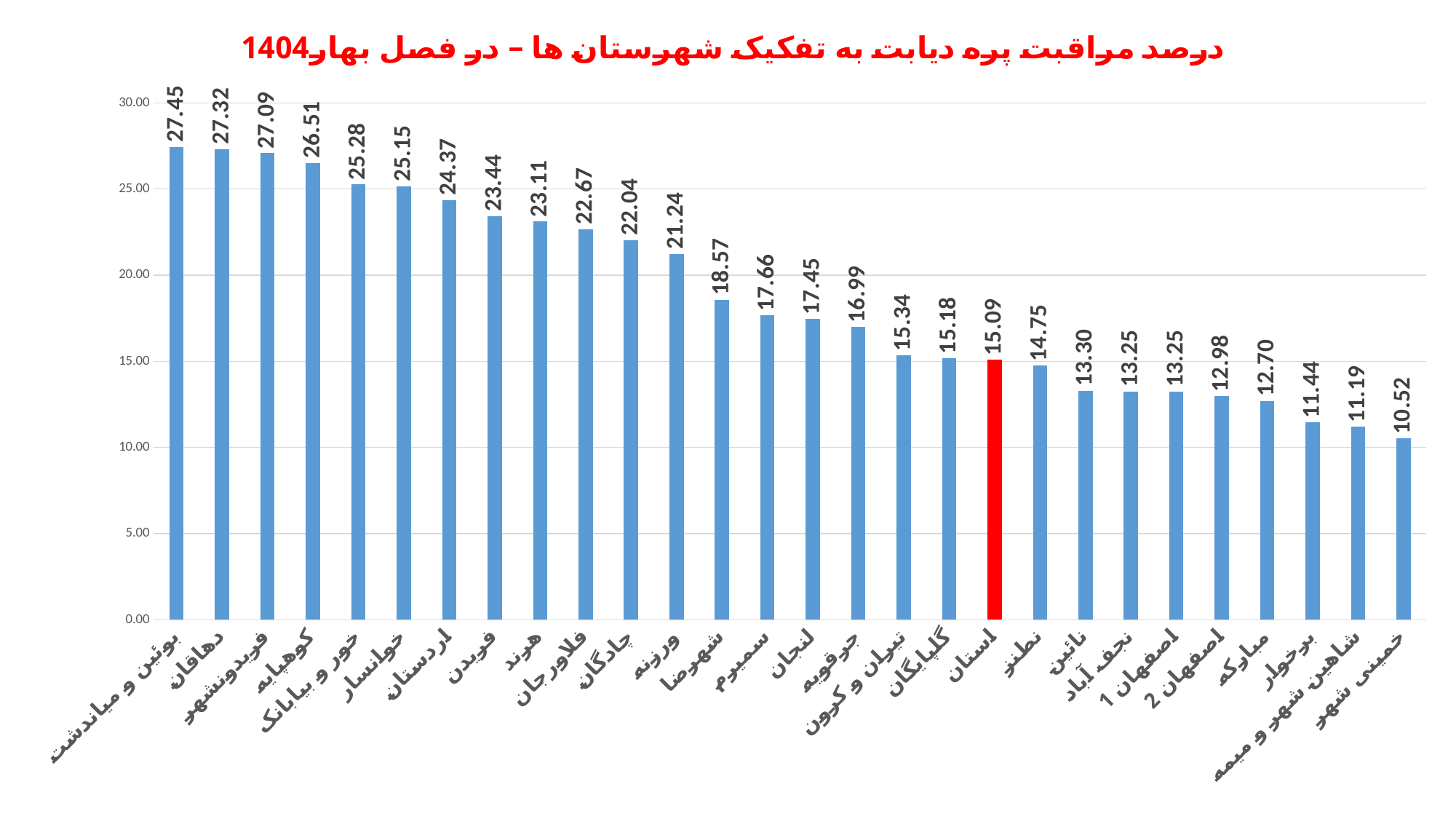
Which bar is coloured red instead of blue? استان What is the value for خمینی شهر? 10.52 Which is larger, the value for فلاورجان or the value for ورزنه? فلاورجان What is the value for استان (the red bar)? 15.09 Which category has the highest value? بوئین و میاندشت What is the value for دهاقان? 27.32 What is the value for شهرضا? 18.57 Which category has the lowest value? خمینی شهر What is the difference between the values for بوئین و میاندشت and خمینی شهر? 16.93 Do the values generally rise or fall from left to right along the x axis? fall What type of chart is shown on the slide? bar chart How many bars are plotted in the chart? 28